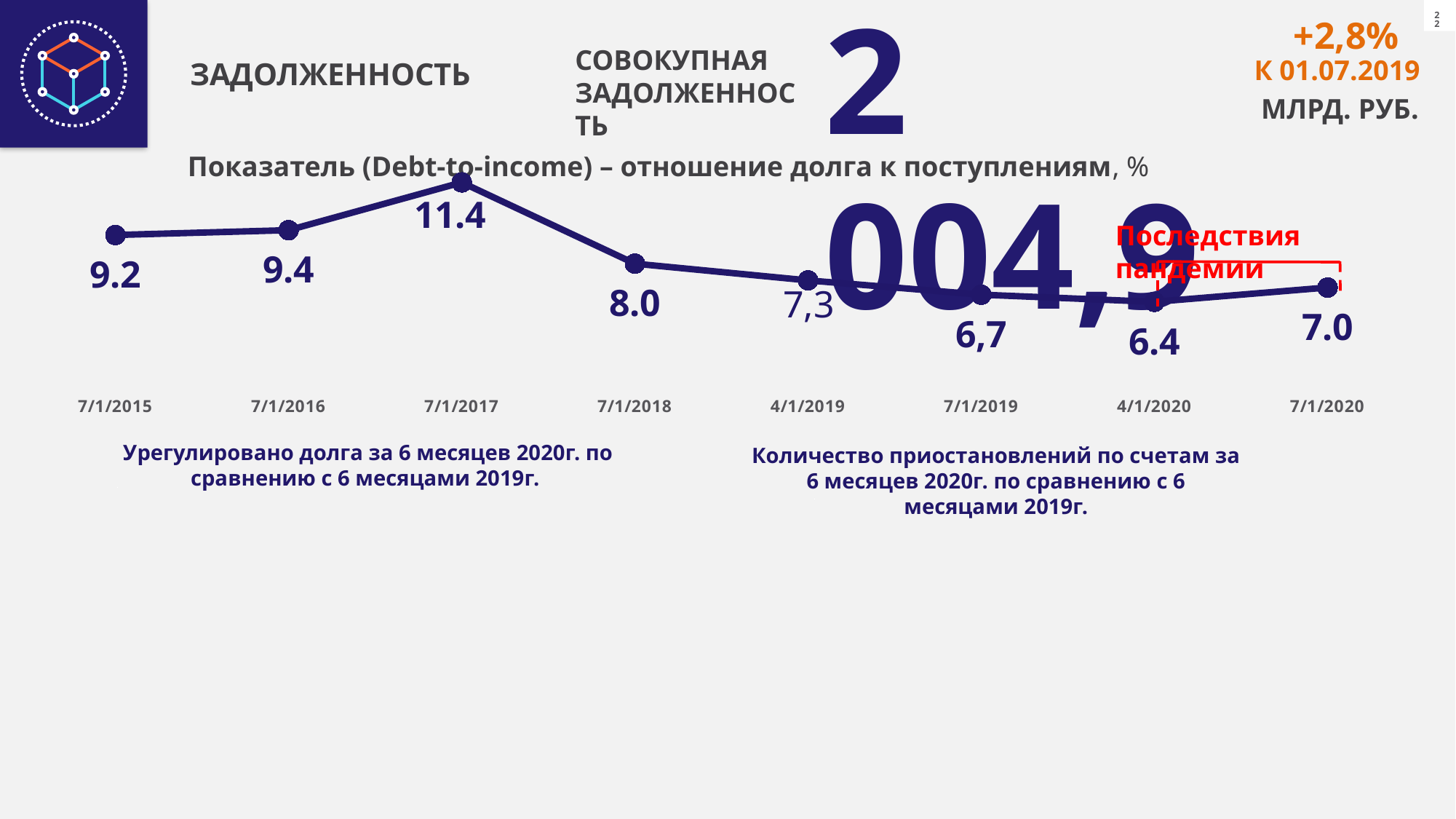
What is the difference between the Debt-to-income values for 7/1/2017 and 7/1/2018? 3.4 What is the Debt-to-income value for 7/1/2015? 9.2 Does the Debt-to-income value rise or fall from 7/1/2017 to 4/1/2020? fall How many data points are plotted on the line chart? 8 What is the Debt-to-income value for 7/1/2017? 11.4 Which date has the lowest Debt-to-income value? 4/1/2020 Which is larger, the Debt-to-income value for 7/1/2016 or for 7/1/2018? 7/1/2016 What is the Debt-to-income value for 4/1/2020? 6.4 What is the Debt-to-income value for 7/1/2020? 7.0 What type of chart is shown on the slide? line chart Which date has the highest Debt-to-income value? 7/1/2017 What is the title of the line chart? Показатель (Debt-to-income) – отношение долга к поступлениям, %